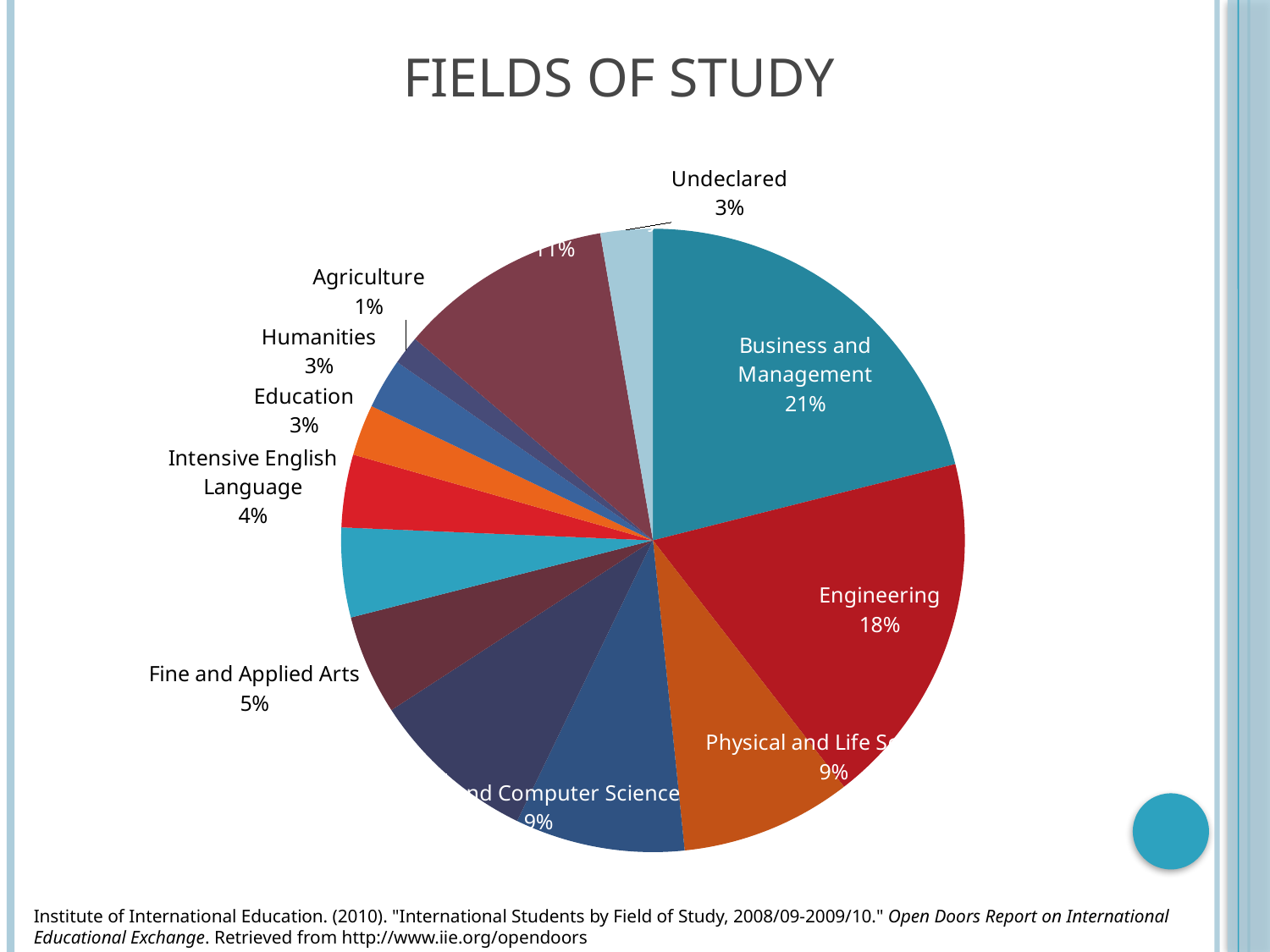
What kind of chart is shown on the slide? Pie chart How many percentage points larger is Business and Management than Engineering? 3 percentage points What is the value shown for Humanities? 3% What is the value shown for Engineering? 18% What is the value shown for Undeclared? 3% Which labelled field of study has the largest share of the pie? Business and Management What is the value shown for Fine and Applied Arts? 5% What is the value shown for Intensive English Language? 4% What percentage of the pie is Business and Management? 21% Which is larger, Fine and Applied Arts or Intensive English Language? Fine and Applied Arts What is the title of the chart? FIELDS OF STUDY Which labelled field of study has the smallest share of the pie? Agriculture